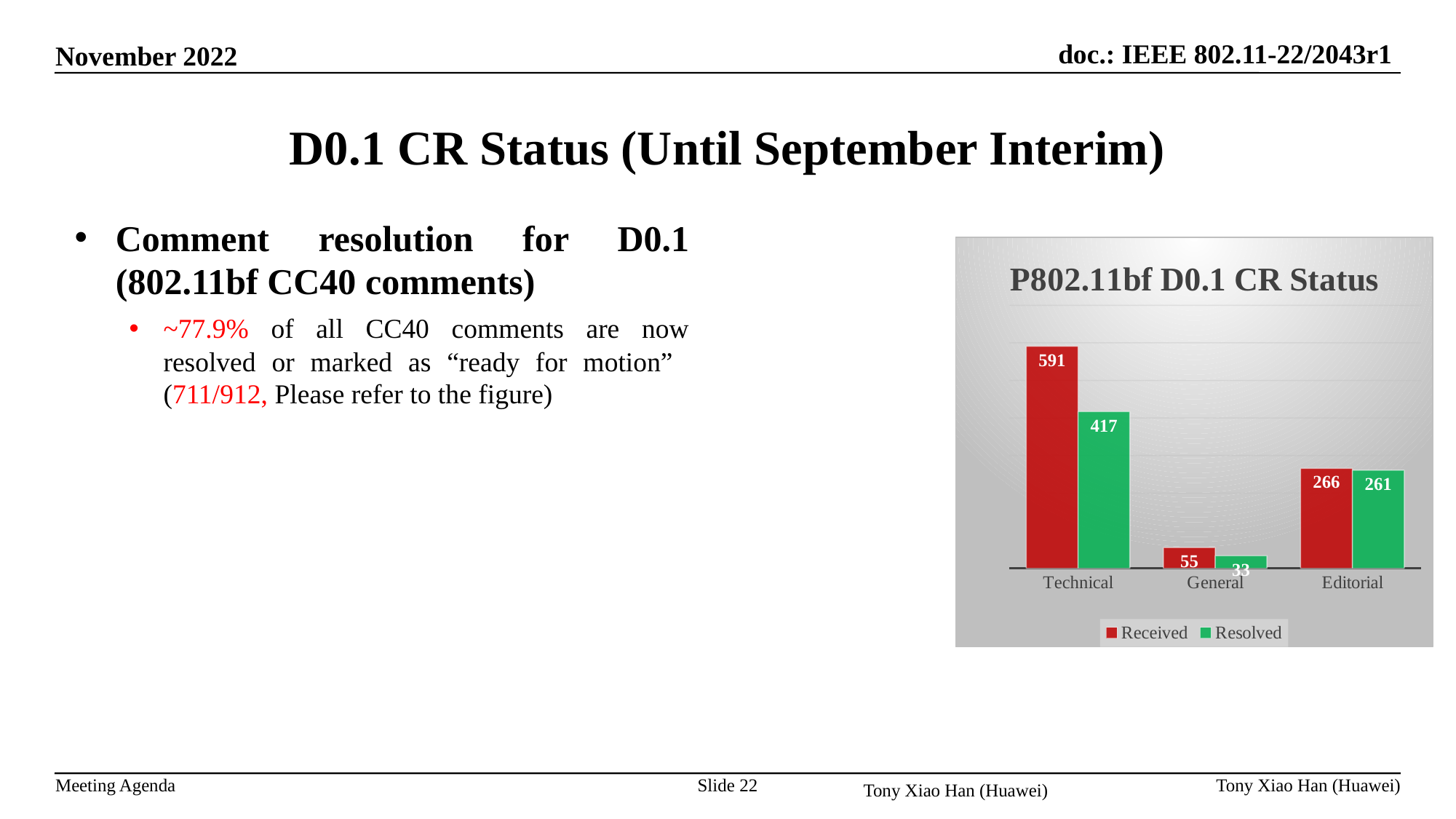
What is the Resolved value for Editorial? 261 What kind of chart is shown on the slide? Bar chart What is the difference between Received and Resolved for Technical? 174 What is the difference between Received and Resolved for General? 22 Which category has the lowest Resolved value? General What is the Resolved value for Technical? 417 What is the Received value for Technical? 591 How many series does the legend list? 2 How many categories are shown on the x axis? 3 Which is larger, the Received value for Editorial or the Resolved value for Technical? Resolved value for Technical What is the Received value for General? 55 Which category has the highest Received value? Technical